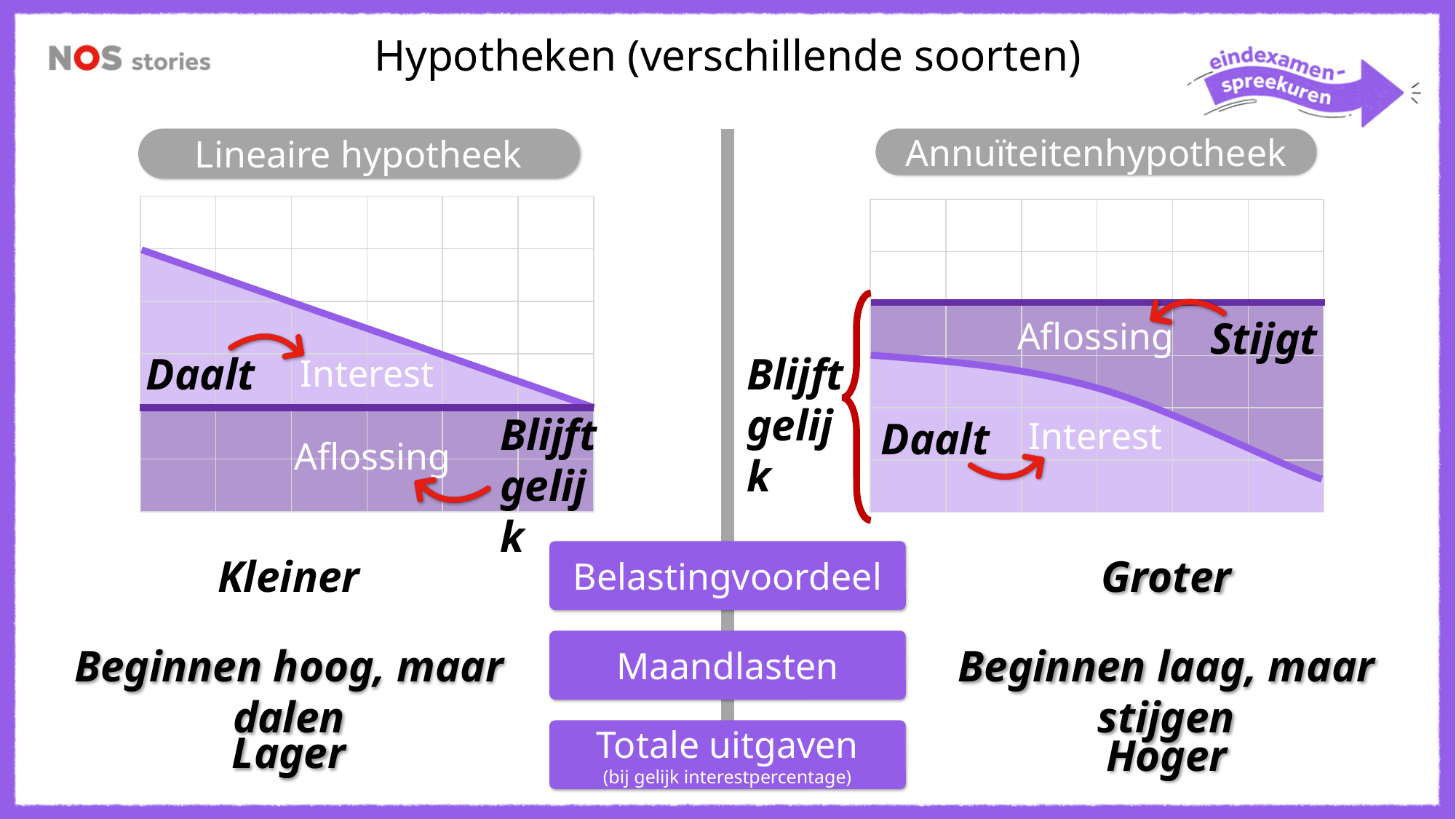
In the "Annuïteitenhypotheek" chart, how many labelled areas (series) are plotted? 2 What is the title of the chart on the left side of the slide? Lineaire hypotheek In the "Annuïteitenhypotheek" chart, does the Aflossing area rise or fall along the x axis? rise In the "Lineaire hypotheek" chart, how many labelled areas (series) are plotted? 2 How many charts are shown on the slide? 2 In the "Annuïteitenhypotheek" chart, does the top boundary of the stacked areas (the total) rise, fall or stay constant along the x axis? stay constant In the "Lineaire hypotheek" chart, does the Interest area rise or fall along the x axis? fall What kind of chart is the "Annuïteitenhypotheek" chart on the right? area chart What kind of chart is the "Lineaire hypotheek" chart on the left? area chart